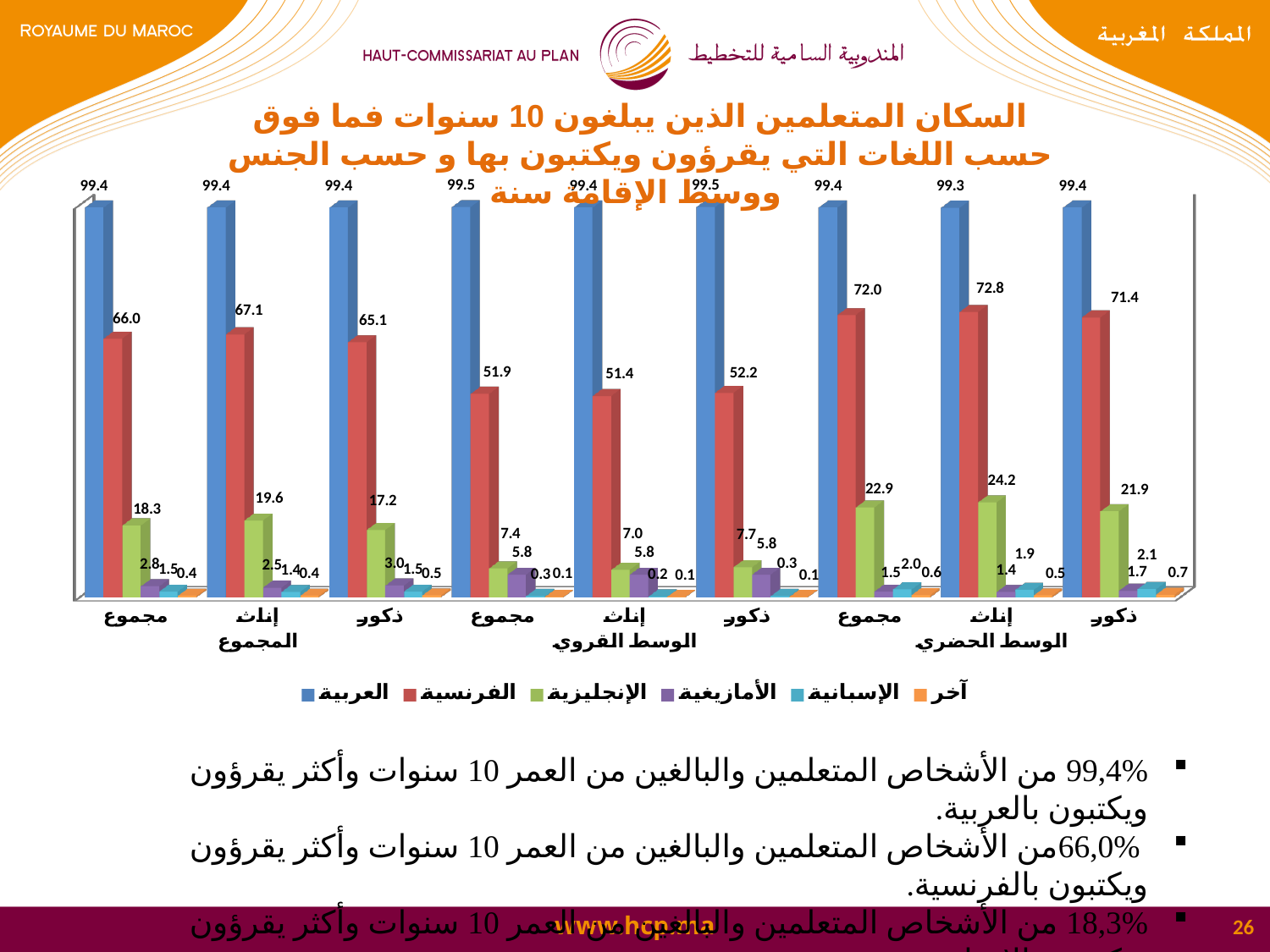
What is the value of الإنجليزية for إناث in the الوسط الحضري group? 24.2 Which is larger: الإنجليزية for مجموع in الوسط الحضري or الإنجليزية for مجموع in الوسط القروي? الوسط الحضري How many category groups (bars clusters) are shown along the x axis? 9 What is the value of الفرنسية for مجموع in the المجموع group? 66.0 What kind of chart is shown on the slide? bar chart What is the value of الأمازيغية for مجموع in the الوسط القروي group? 5.8 Which colour represents the العربية series in the legend? blue Which series has the highest value for ذكور in the الوسط الحضري group? العربية What is the difference between the الفرنسية values for إناث and ذكور in the الوسط الحضري group? 1.4 Which series has the lowest value for مجموع in the الوسط القروي group? آخر What is the value of العربية for إناث in the الوسط الحضري group? 99.3 How many series does the legend list? 6